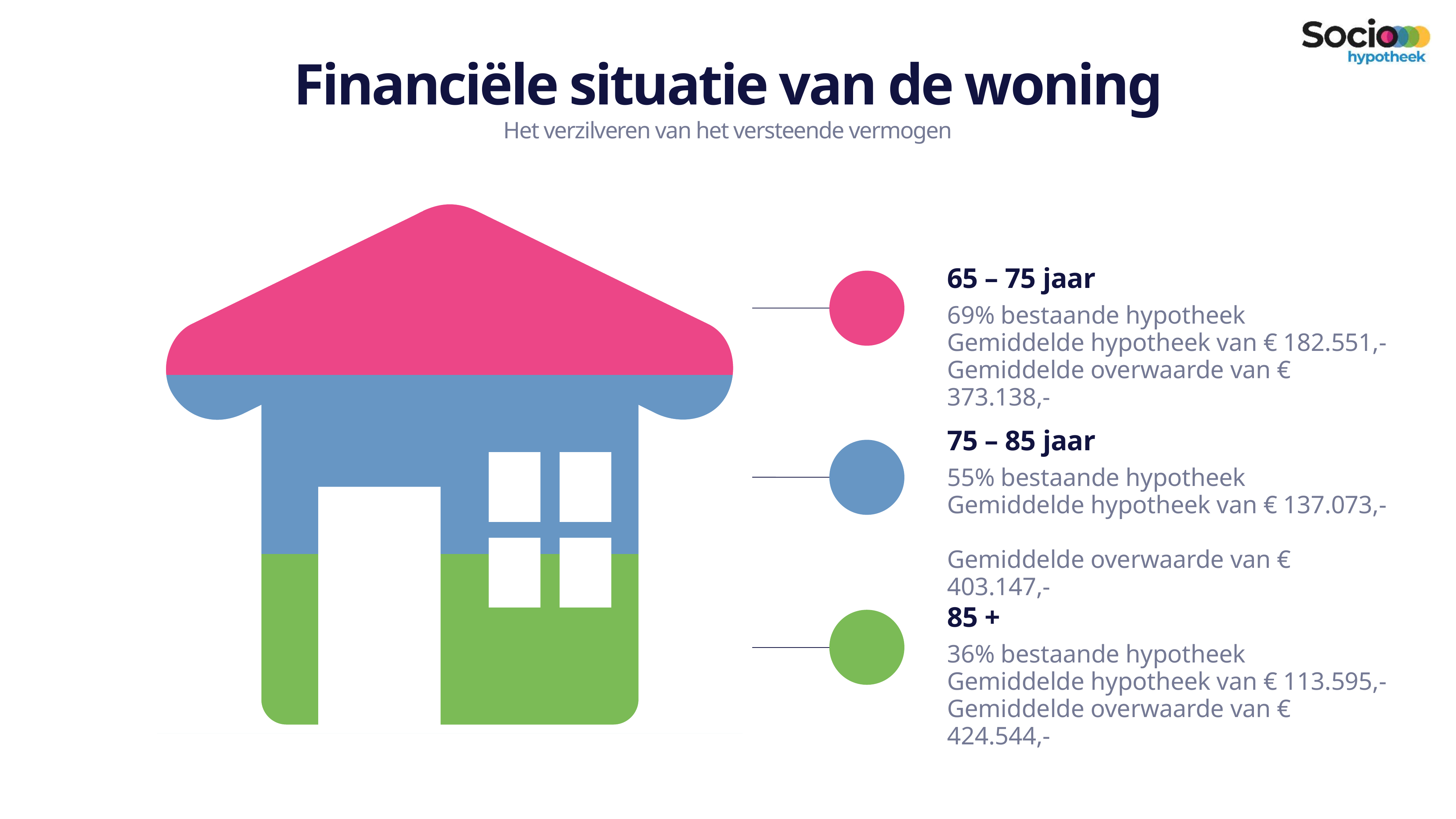
What is the difference between the gemiddelde overwaarde of the 85 + group and the 65 – 75 jaar group? € 51.406,- What is the difference in percentage points between the share with a bestaande hypotheek in the 65 – 75 jaar group and the 85 + group? 33 percentage points What is the gemiddelde overwaarde for the 65 – 75 jaar group? € 373.138,- Which is larger: the gemiddelde hypotheek of the 65 – 75 jaar group or of the 75 – 85 jaar group? 65 – 75 jaar Which age group has the highest percentage with a bestaande hypotheek? 65 – 75 jaar Which age group has the lowest gemiddelde hypotheek? 85 + What percentage of the 65 – 75 jaar group has a bestaande hypotheek? 69% What is the gemiddelde overwaarde for the 85 + group? € 424.544,- Which colour represents the 75 – 85 jaar group in the house graphic? Blue What is the gemiddelde hypotheek for the 75 – 85 jaar group? € 137.073,- Which age group has the highest gemiddelde overwaarde? 85 + How many age groups are shown on the slide? 3